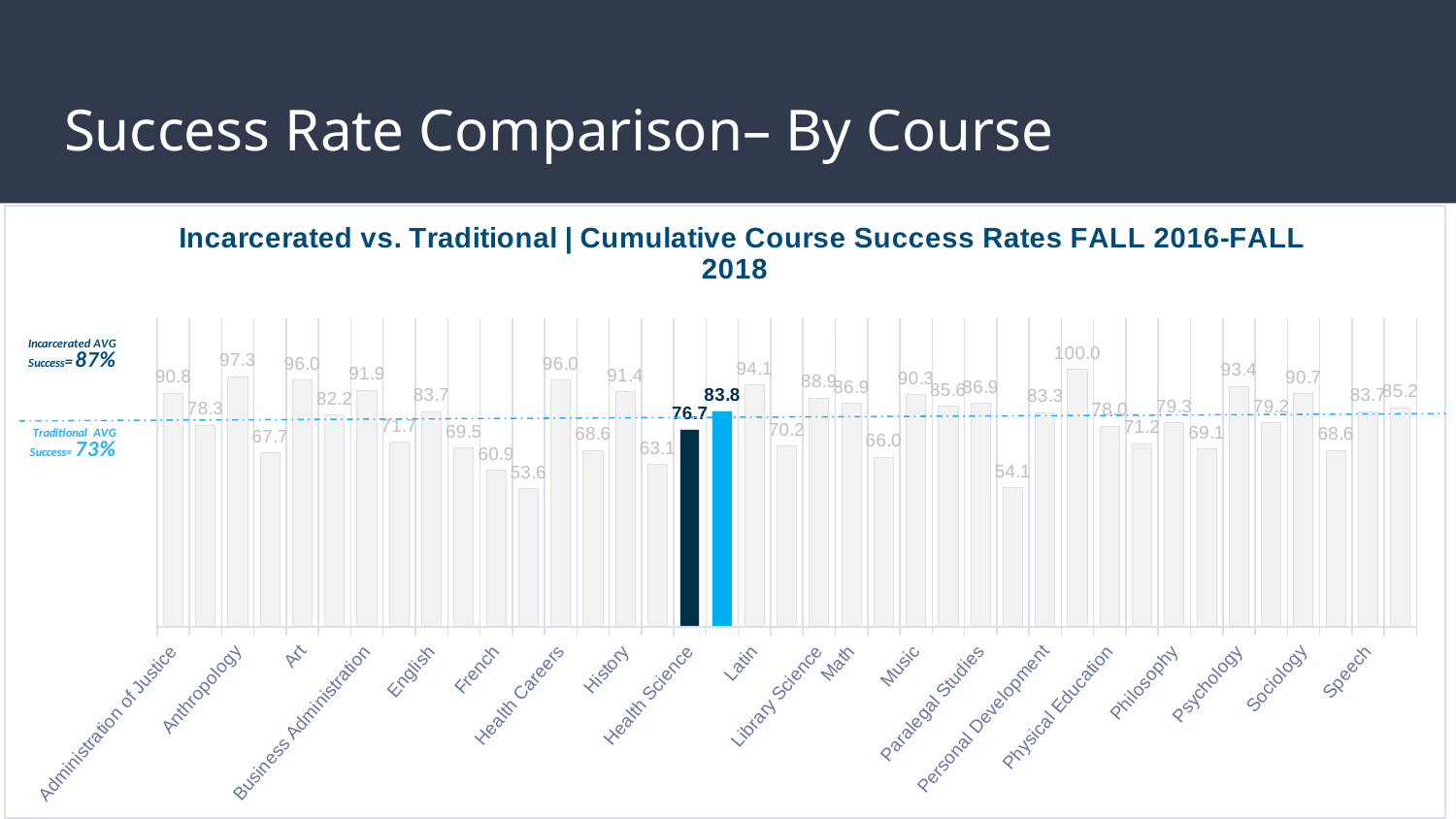
What is the difference between the two Health Science bars (83.8 and 76.7)? 7.1 What type of chart is shown on the slide? bar chart What is the Traditional AVG Success rate shown on the chart? 73% What is the lowest value labeled on any bar in the chart? 53.6 For Health Science, which bar is larger, the dark blue bar or the light blue bar? the light blue bar Which course is highlighted with dark and light blue bars in the chart? Health Science What is the title of the chart? Incarcerated vs. Traditional | Cumulative Course Success Rates FALL 2016-FALL 2018 What is the value of the dark blue bar for Health Science? 76.7 What is the highest value labeled on any bar in the chart? 100.0 What is the value of the light blue bar for Health Science? 83.8 What is the Incarcerated AVG Success rate shown on the chart? 87% How many courses are listed along the x axis of the chart? 20